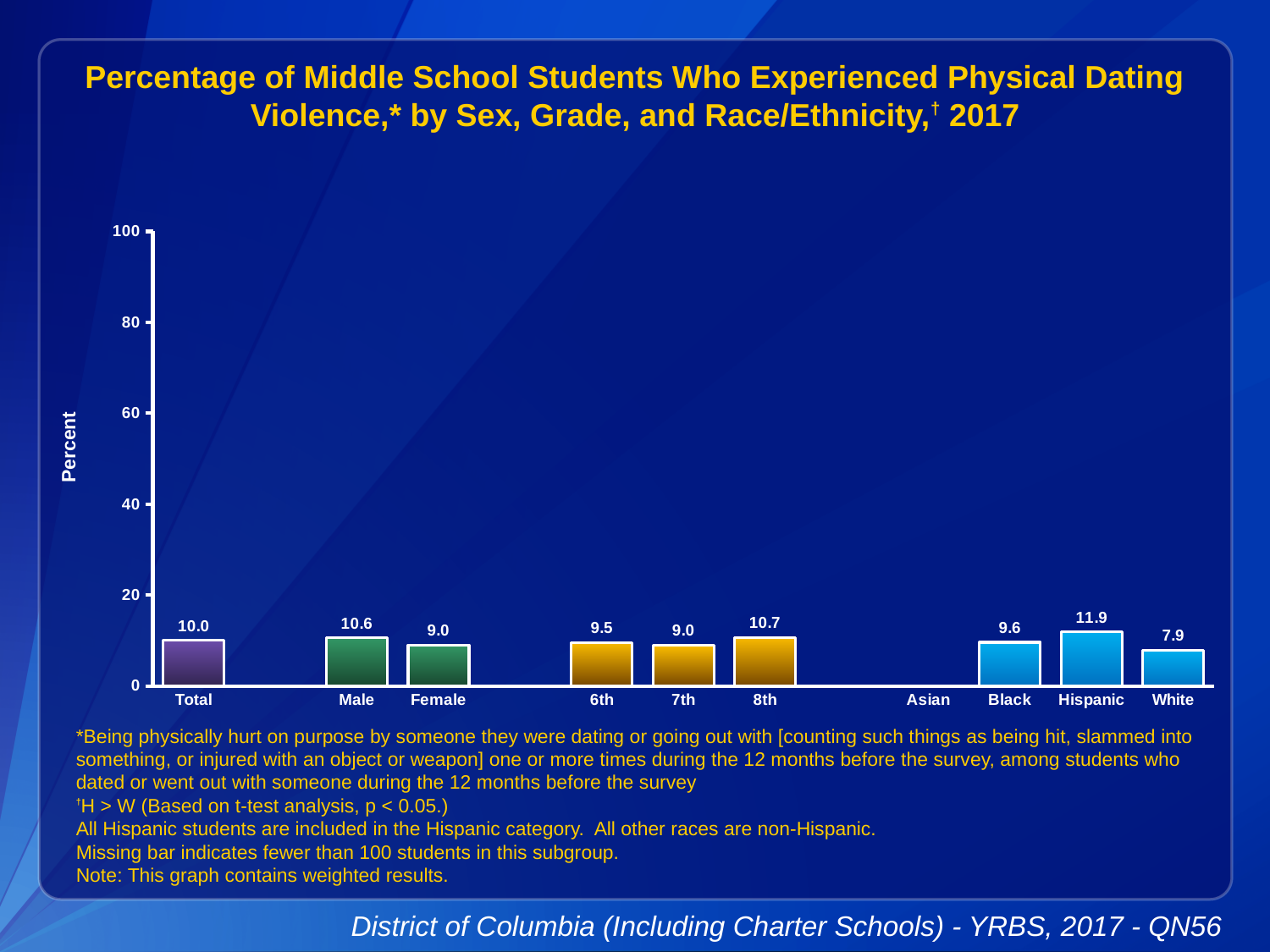
Which category has the highest value? Hispanic Which category on the x axis has no bar shown? Asian What is the difference between the Male and Female values? 1.6 What is the value for Hispanic? 11.9 What is the value for Total? 10.0 What is the value for White? 7.9 Which category has the lowest value among those with a bar shown? White How many categories have a bar plotted on the chart? 9 Is the value for Black greater or less than 20? less Which is larger, the value for 8th or the value for 6th? 8th What is the value for Male? 10.6 What kind of chart is shown? bar chart